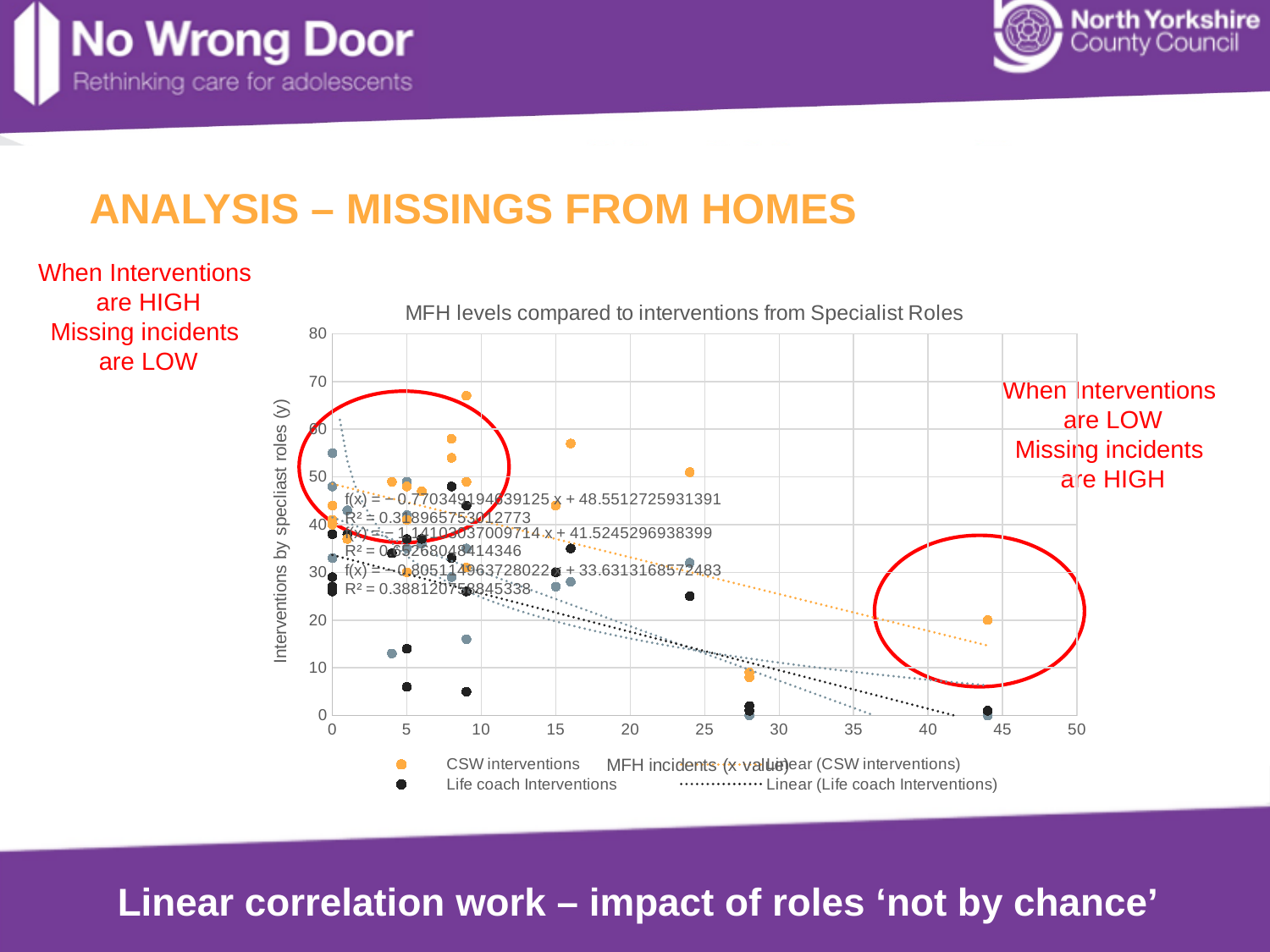
Is the highest CSW interventions point on the chart greater or less than 60? greater What is the title of the chart? MFH levels compared to interventions from Specialist Roles Is the highest Life coach Interventions point greater or less than 40? greater What kind of chart is shown on the slide? Scatter chart What is the maximum value shown on the y axis? 80 How many entries does the chart legend list? 4 According to the fitted trend lines, do interventions rise or fall as MFH incidents increase along the x axis? Fall What is the label of the x axis? MFH incidents (x value) Is the CSW interventions point plotted at about 44 MFH incidents greater or less than 30 on the y axis? less